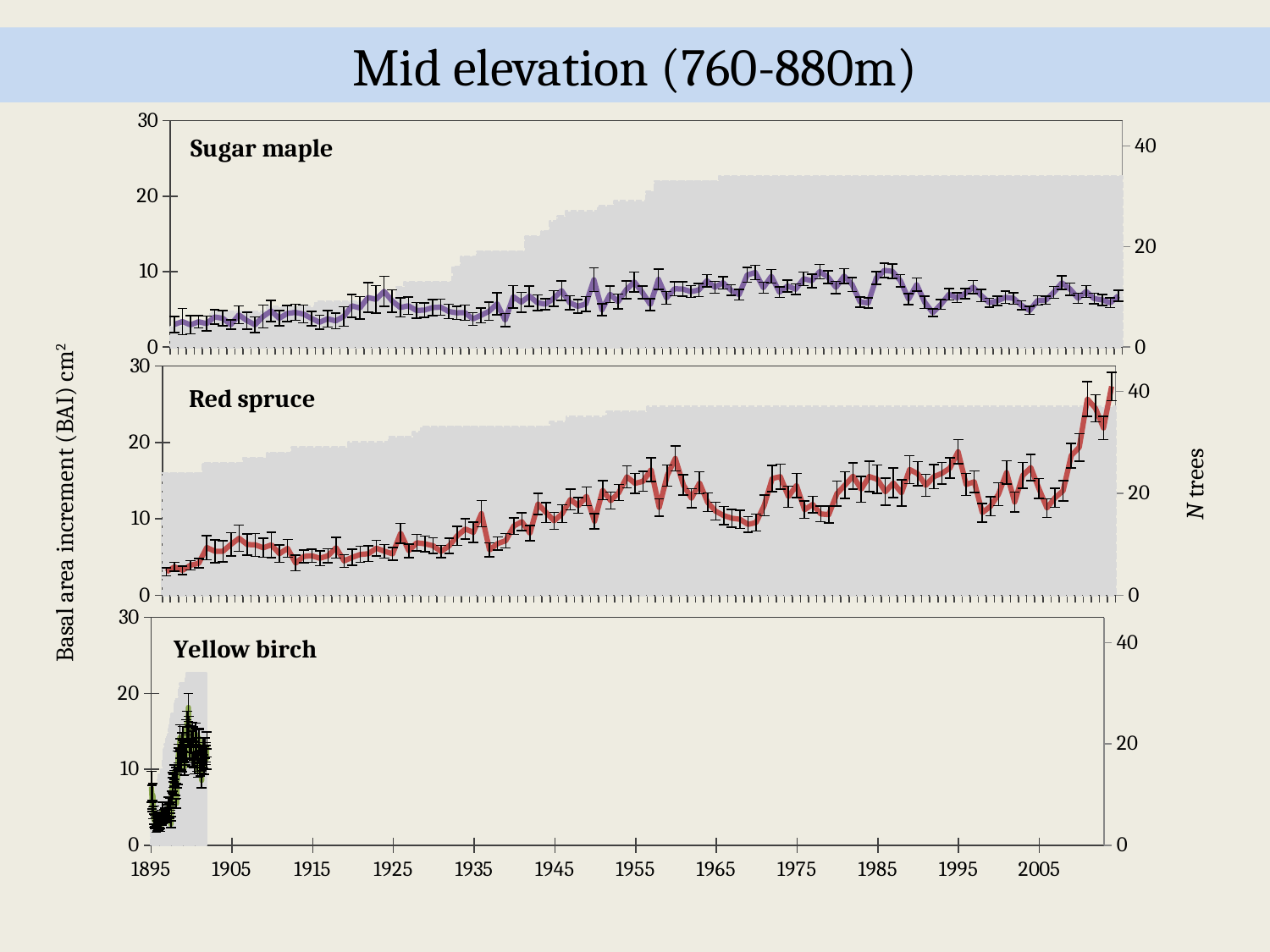
What kind of chart is used in each of the three panels on the slide? combination bar and line chart In the Red spruce panel, does the basal area increment generally rise or fall from 1895 to the end of the series? rise Around 2010, which species has the larger basal area increment, Sugar maple or Red spruce? Red spruce Which species panel has data only for the earliest years (ending around 1902)? Yellow birch In the Sugar maple panel, is the highest value of the line greater or less than 20? less What is the label on the shared left y-axis of the charts? Basal area increment (BAI) cm² How many species panels are shown on the slide? 3 In the Red spruce panel, is the value around 1960 greater or less than 10? greater In the Sugar maple panel, is the value in 1895 greater or less than 10? less What is the title of the slide above the charts? Mid elevation (760-880m)